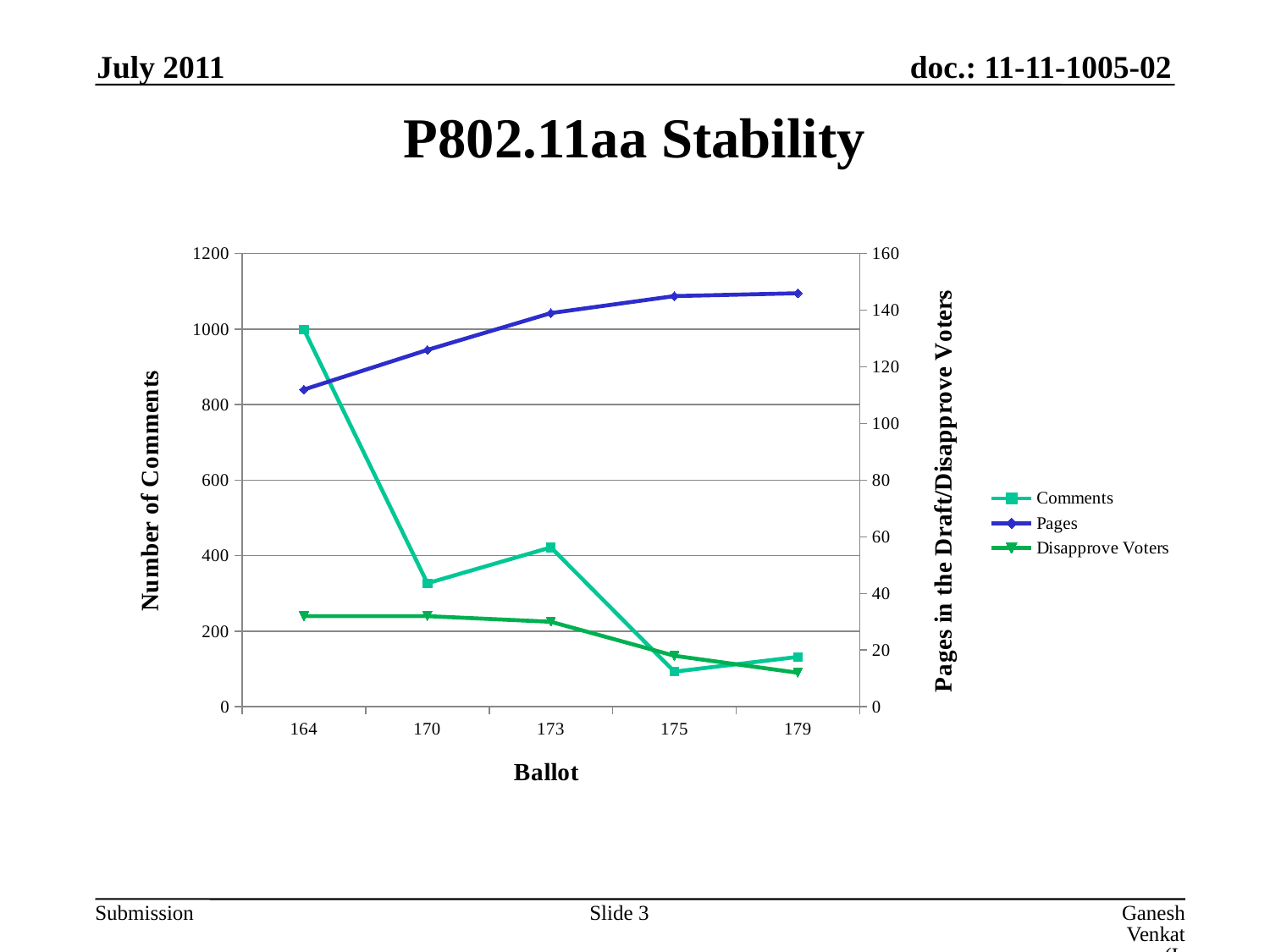
How many series does the legend list? 3 Is the Disapprove Voters value for ballot 164 greater or less than 20? greater At which ballot is the Pages value lowest? 164 Is the Comments value for ballot 170 greater or less than 400? less How many ballot values are plotted along the x axis? 5 What is the title of the left vertical axis? Number of Comments Is the Comments value for ballot 164 greater or less than 800? greater Does the Comments series rise or fall from ballot 164 to ballot 170? fall What kind of chart is shown on the slide? line chart At which ballot is the Comments value highest? 164 Does the Pages series rise or fall from ballot 164 to ballot 179? rise